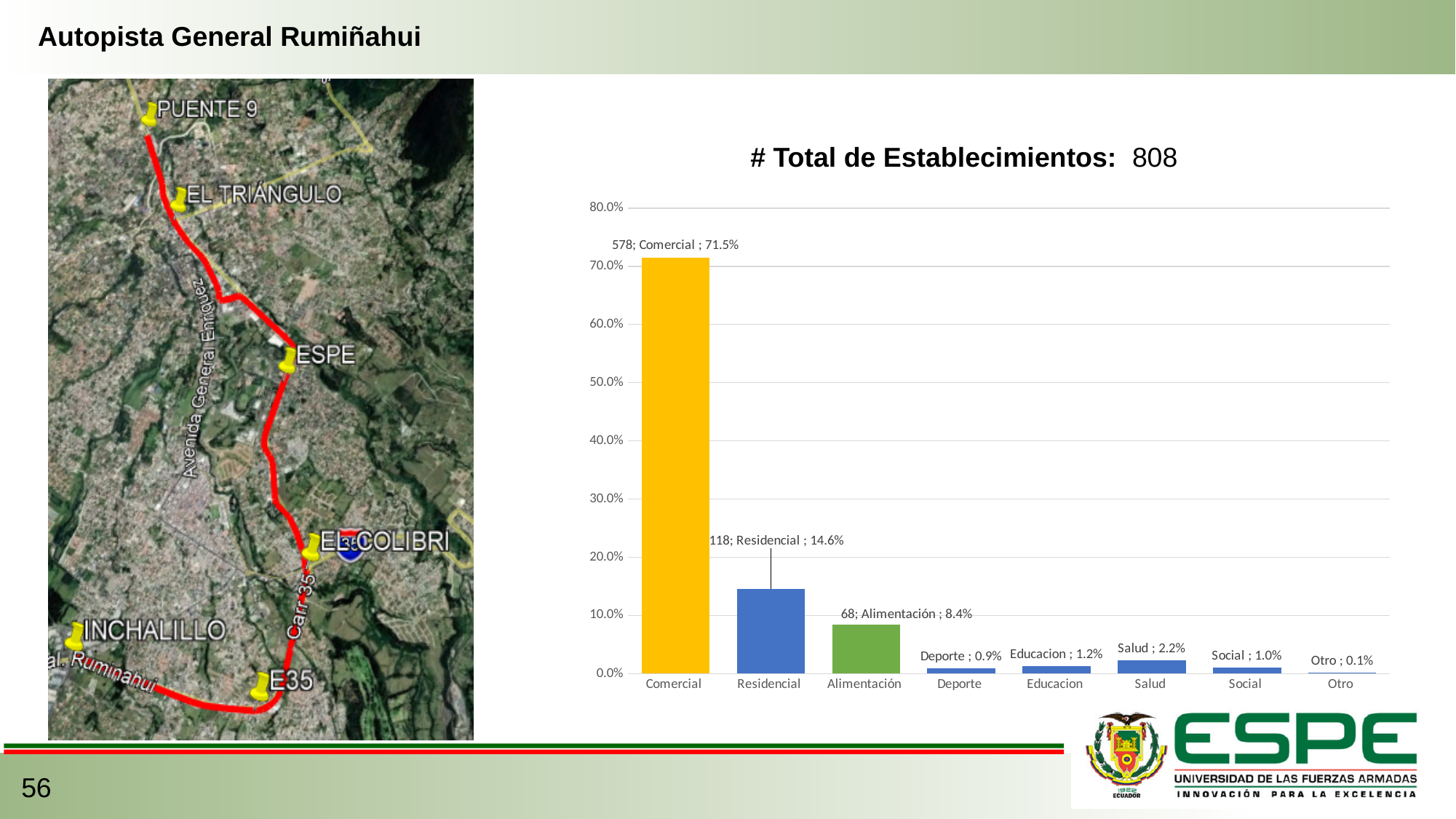
What percentage is shown for Comercial? 71.5% What percentage is shown for Salud? 2.2% What is the difference in percentage points between Comercial and Residencial? 56.9 How many establishments are labelled for Comercial? 578 Which category has the highest percentage? Comercial What percentage is shown for Alimentación? 8.4% What kind of chart is shown on the slide? bar chart How many categories are shown on the x axis of the bar chart? 8 What percentage is shown for Otro? 0.1% What percentage is shown for Residencial? 14.6% Which is larger, the percentage for Educacion or the percentage for Deporte? Educacion Which category has the lowest percentage? Otro